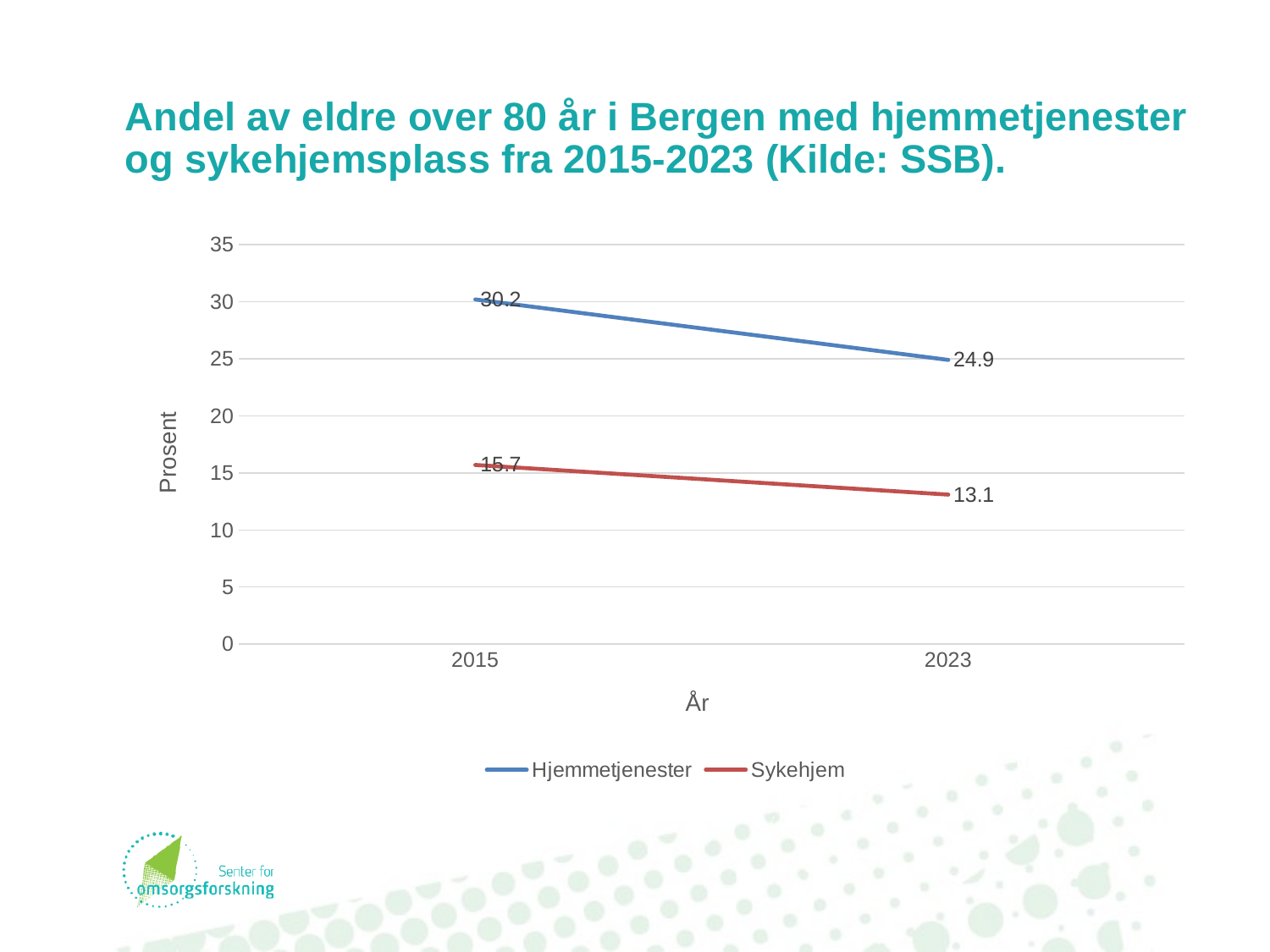
Does the Sykehjem series rise or fall from 2015 to 2023? fall How many series does the legend list? 2 What is the value for Hjemmetjenester in 2023? 24.9 What is the difference between Hjemmetjenester and Sykehjem in 2023? 11.8 Which series has the higher value in 2015, Hjemmetjenester or Sykehjem? Hjemmetjenester What is the value for Hjemmetjenester in 2015? 30.2 What is the label of the y axis? Prosent By how much did the Hjemmetjenester value fall from 2015 to 2023? 5.3 What kind of chart is shown on the slide? line chart How many years are shown on the x axis? 2 What is the value for Sykehjem in 2015? 15.7 What is the value for Sykehjem in 2023? 13.1